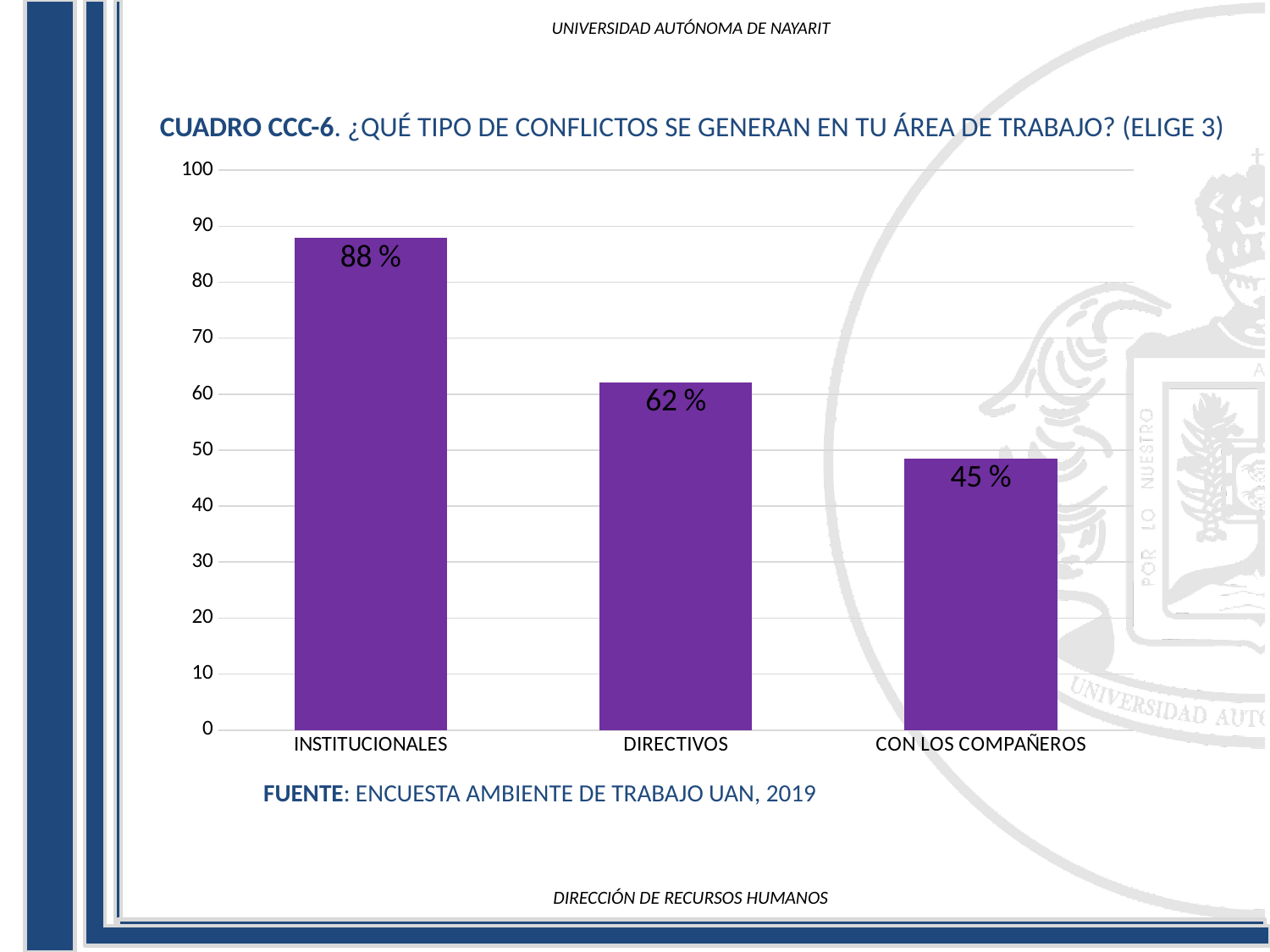
Which is larger, the value for DIRECTIVOS or the value for CON LOS COMPAÑEROS? DIRECTIVOS What is the value for DIRECTIVOS? 62 % What source is cited below the chart? ENCUESTA AMBIENTE DE TRABAJO UAN, 2019 How many categories are shown on the chart? 3 Is the value for CON LOS COMPAÑEROS greater or less than 50? less Which category has the lowest value? CON LOS COMPAÑEROS What is the difference between the values for DIRECTIVOS and CON LOS COMPAÑEROS? 17 % Which category has the highest value? INSTITUCIONALES What is the value for CON LOS COMPAÑEROS? 45 % What kind of chart is shown on the slide? bar chart What is the value for INSTITUCIONALES? 88 % What is the difference between the values for INSTITUCIONALES and DIRECTIVOS? 26 %